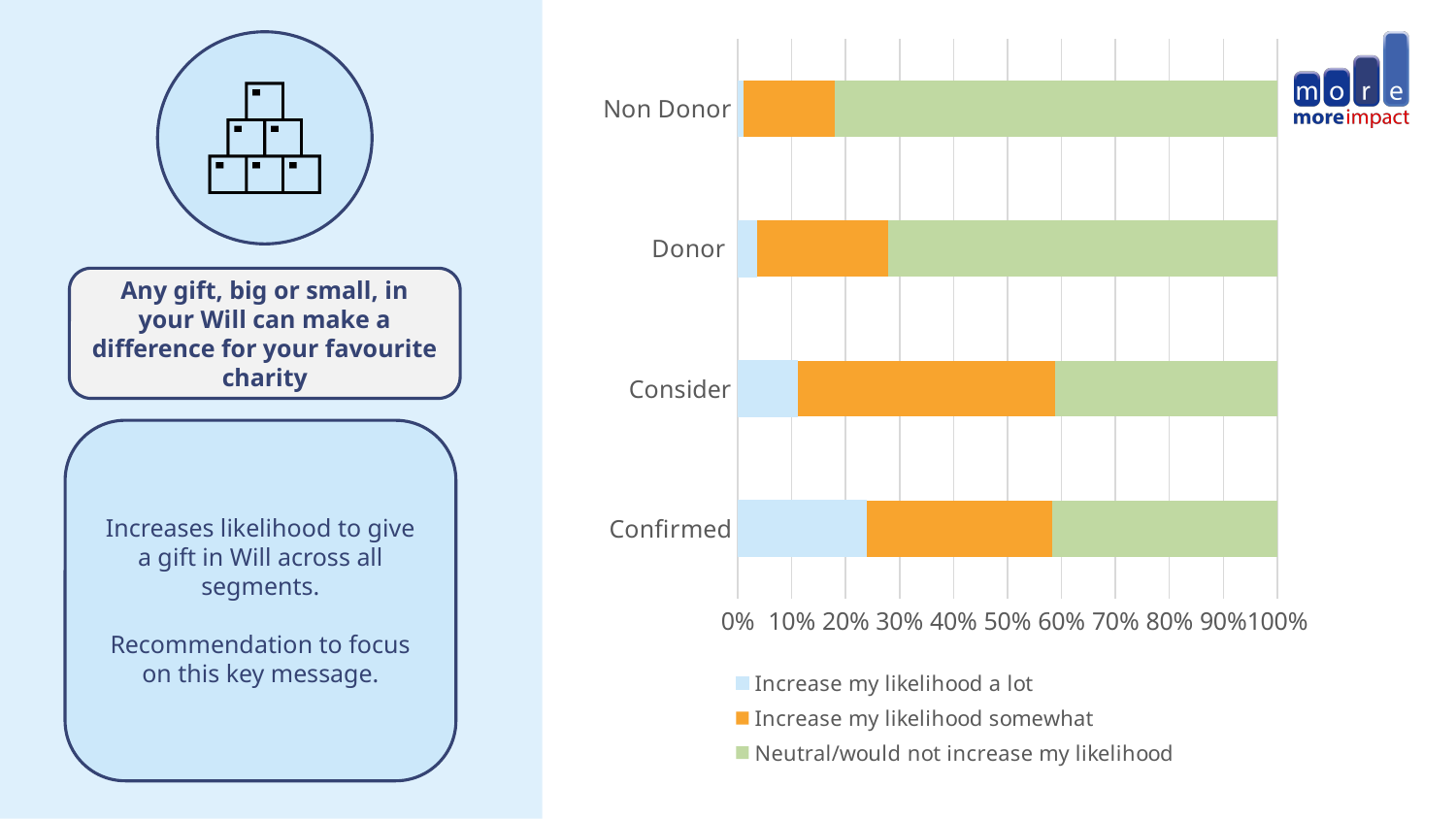
Which category has the largest 'Increase my likelihood somewhat' segment? Consider Is the 'Increase my likelihood somewhat' share for Non Donor greater or less than 20%? less How many categories are plotted on the chart? 4 Which category has the largest 'Neutral/would not increase my likelihood' segment? Non Donor Which has the larger 'Increase my likelihood somewhat' segment, Non Donor or Donor? Donor Is the 'Neutral/would not increase my likelihood' share for Non Donor greater or less than 80%? greater Which category has the largest 'Increase my likelihood a lot' segment? Confirmed Which has the larger 'Increase my likelihood a lot' segment, Consider or Confirmed? Confirmed What kind of chart is shown on the slide? Stacked bar chart What colour represents 'Increase my likelihood somewhat' in the chart? Orange How many series does the chart legend list? 3 Is the 'Increase my likelihood a lot' share for Confirmed greater or less than 20%? greater